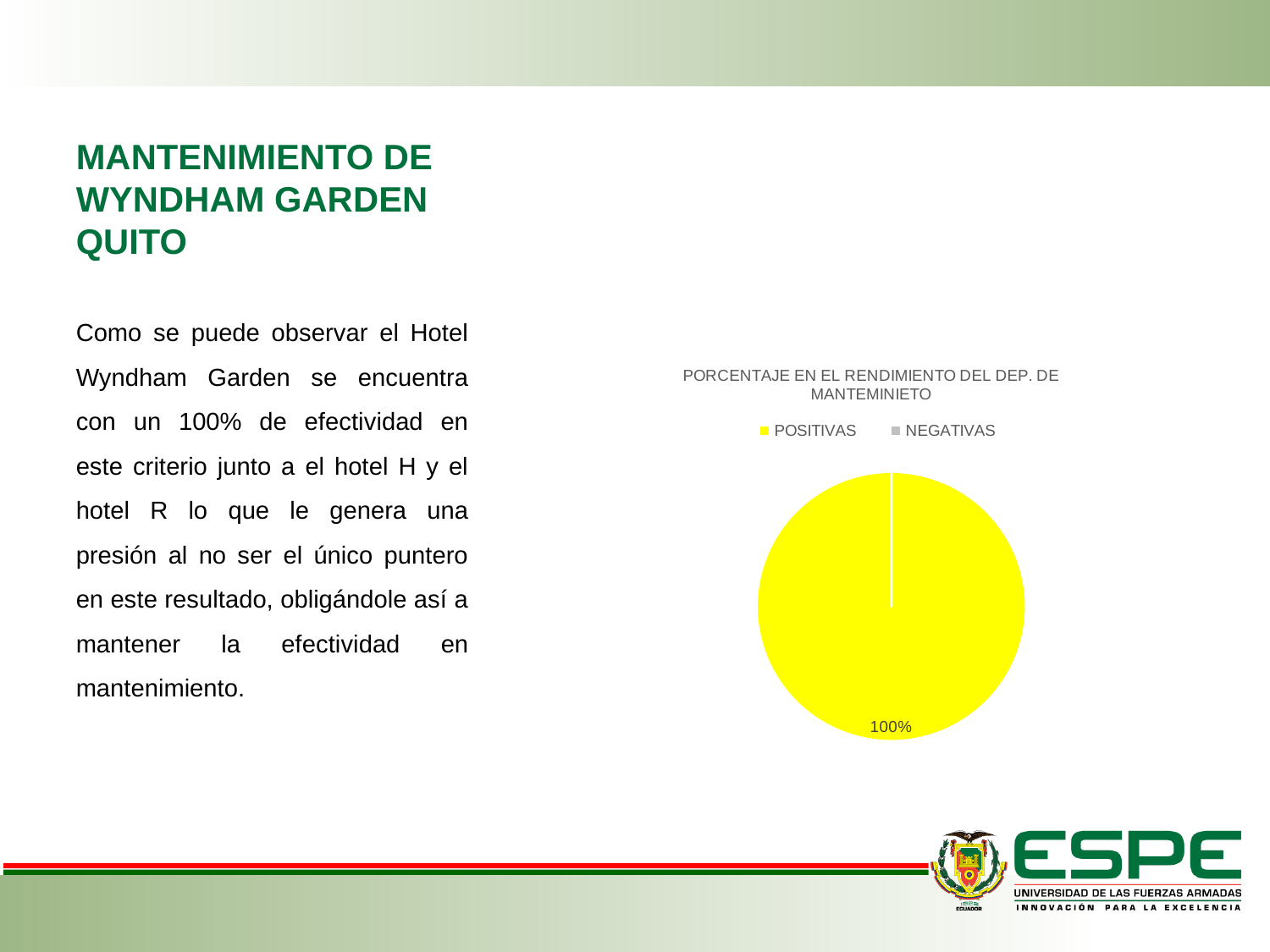
Which category takes the smallest share of the pie? NEGATIVAS How many entries does the chart's legend list? 2 What colour represents POSITIVAS in the pie chart? yellow Which category takes the largest share of the pie? POSITIVAS What value is printed on the pie chart? 100% What kind of chart is shown on the slide? pie chart What share of the pie does POSITIVAS take? 100% What is the title of the chart on the slide? PORCENTAJE EN EL RENDIMIENTO DEL DEP. DE MANTEMINIETO Which is larger in the pie chart, POSITIVAS or NEGATIVAS? POSITIVAS Is the share for POSITIVAS greater or less than 50%? greater